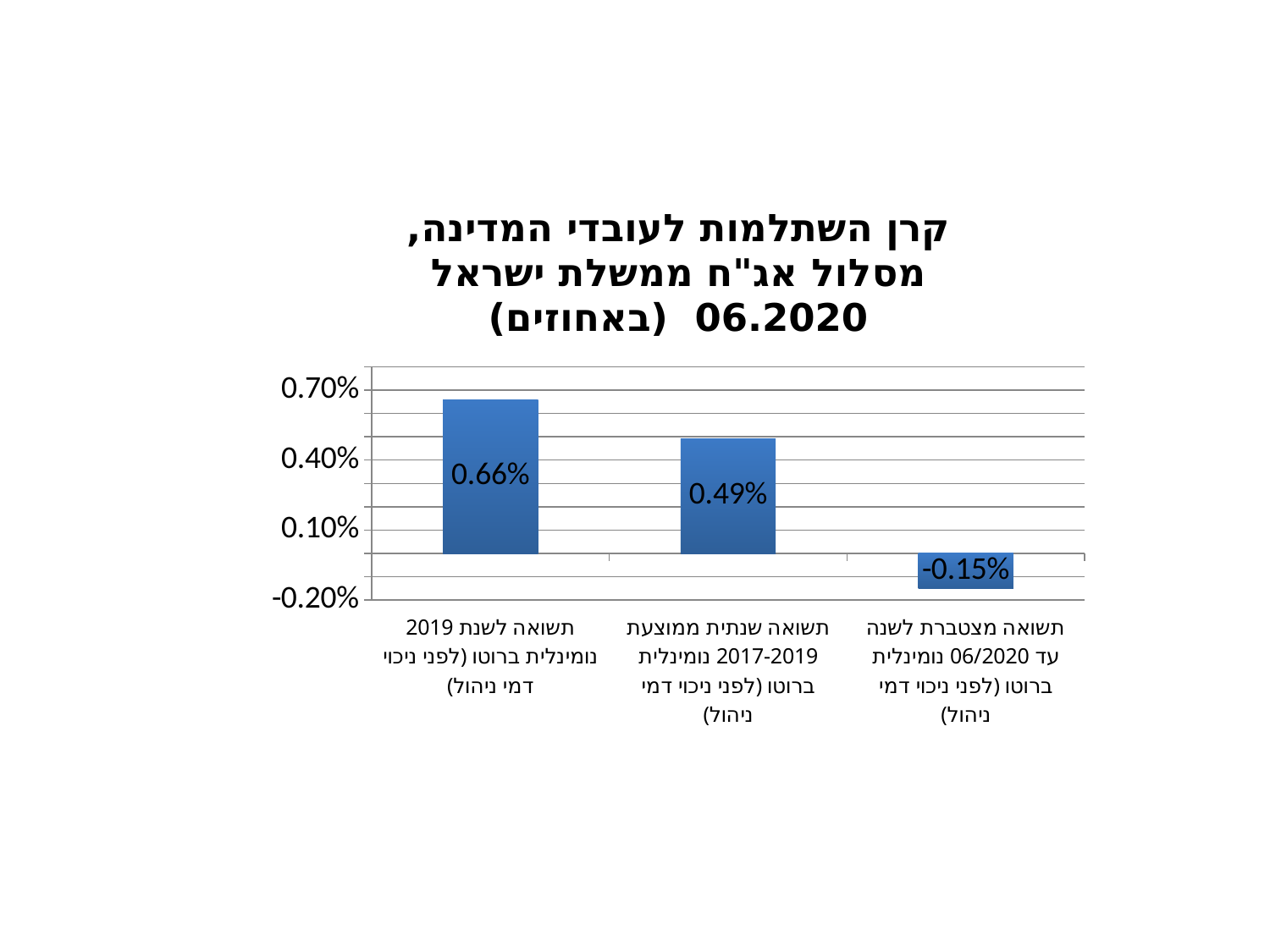
Which is larger: the 2019 return or the 2017-2019 average annual return? The 2019 return (0.66%) Which category has the lowest value? תשואה מצטברת לשנה עד 06/2020 נומינלית ברוטו (לפני ניכוי דמי ניהול) Do the values rise or fall from left to right across the categories? Fall What is the difference between the 2019 return (0.66%) and the 2017-2019 average annual return (0.49%)? 0.17% What is the value for the average annual nominal gross return 2017-2019 (תשואה שנתית ממוצעת 2017-2019)? 0.49% What kind of chart is shown on the slide? Bar chart Is the value for the 2019 return greater or less than 0.40%? greater How many categories are shown in the chart? 3 Which category has the highest value? תשואה לשנת 2019 נומינלית ברוטו (לפני ניכוי דמי ניהול) What is the value for the cumulative return for the year to 06/2020 (תשואה מצטברת לשנה עד 06/2020)? -0.15% Which investment track is named in the chart title? מסלול אג"ח ממשלת ישראל What is the value for the 2019 nominal gross return (תשואה לשנת 2019 נומינלית ברוטו)? 0.66%